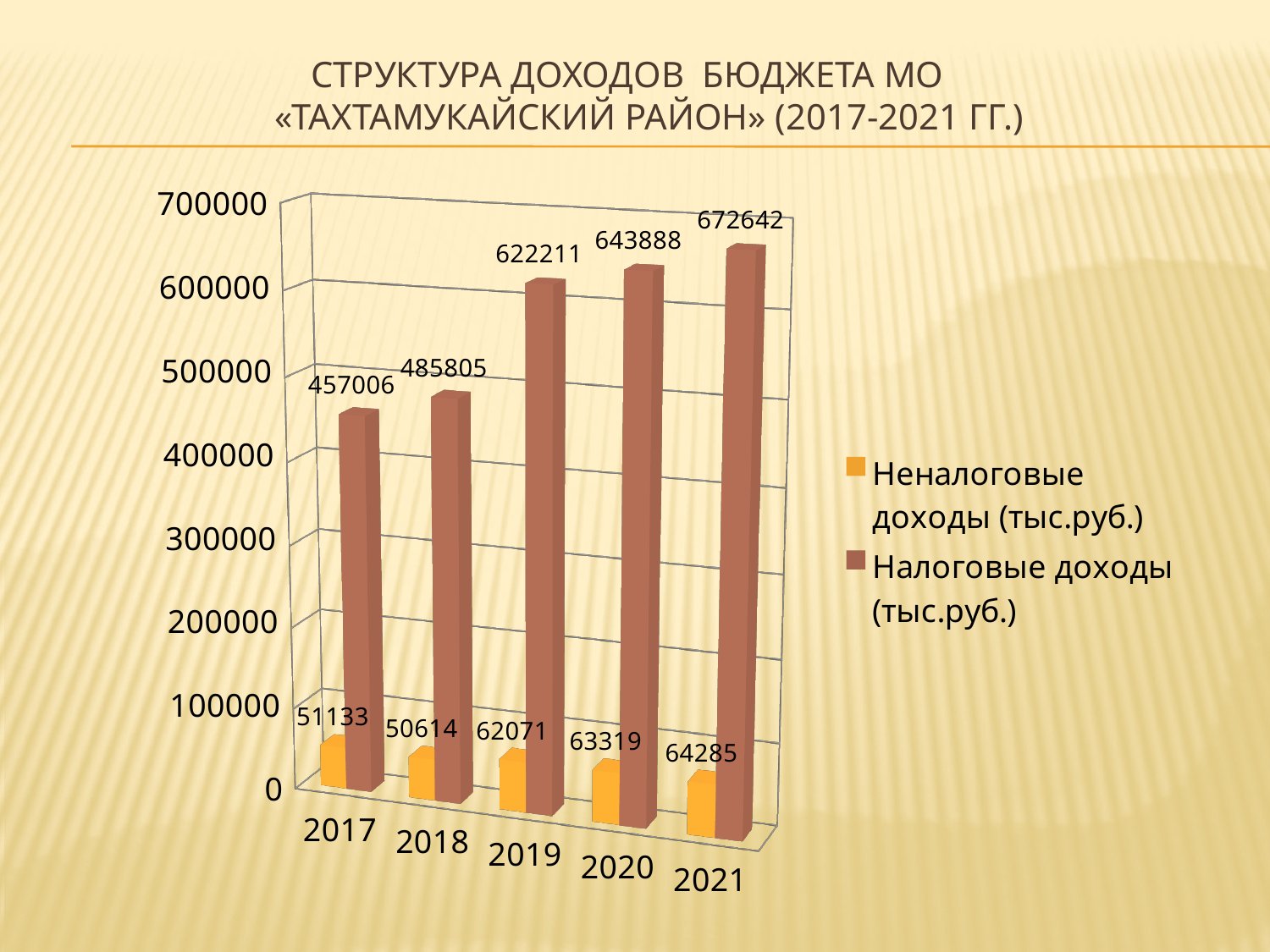
What is the value of Неналоговые доходы (тыс.руб.) for 2021? 64285 What kind of chart is shown on the slide? bar chart How many series does the legend list? 2 What is the value of Неналоговые доходы (тыс.руб.) for 2017? 51133 In which year is Налоговые доходы (тыс.руб.) highest? 2021 What is the difference between Неналоговые доходы (тыс.руб.) in 2020 and in 2019? 1248 How many years are shown on the x axis? 5 What is the value of Налоговые доходы (тыс.руб.) for 2019? 622211 Which is larger: Налоговые доходы (тыс.руб.) in 2018 or in 2019? 2019 What is the difference between Налоговые доходы (тыс.руб.) in 2021 and in 2017? 215636 Is the value of Налоговые доходы (тыс.руб.) for 2020 greater or less than 600000? greater In which year is Неналоговые доходы (тыс.руб.) lowest? 2018